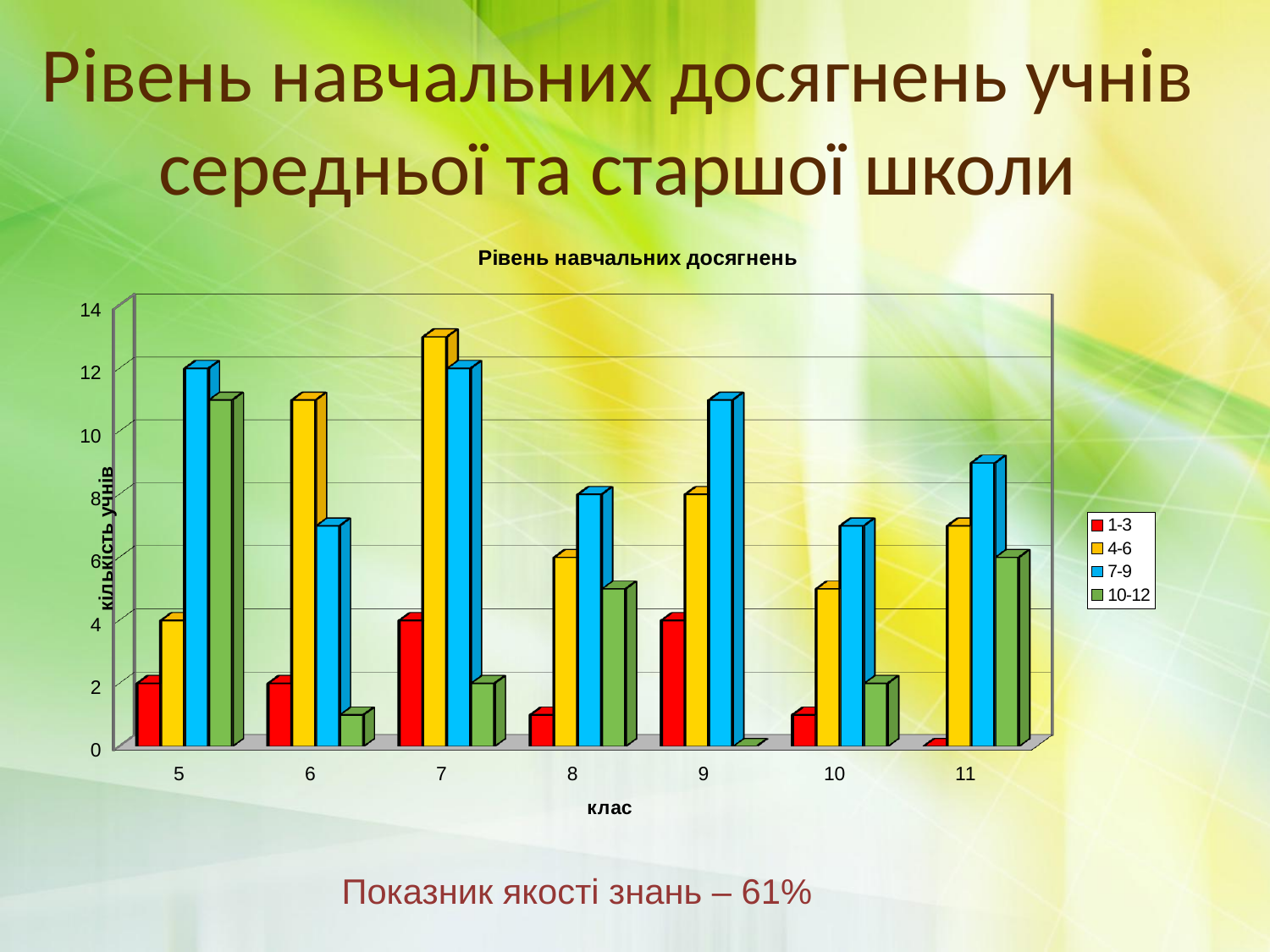
How many series does the legend list? 4 What is the label of the x axis of the chart? клас Is the value of the 7-9 series for class 10 greater or less than 8? less Which is larger: the 7-9 value for class 5 or the 7-9 value for class 11? class 5 What is the value of the 7-9 series for class 5? 12 What is the value of the 10-12 series for class 11? 6 What is the value of the 7-9 series for class 8? 8 Is the value of the 4-6 series for class 6 greater or less than 10? greater Which class has the highest 10-12 bar? 5 How many classes (categories) are shown on the x axis? 7 Which class has the highest 4-6 bar? 7 What kind of chart is shown on the slide? bar chart